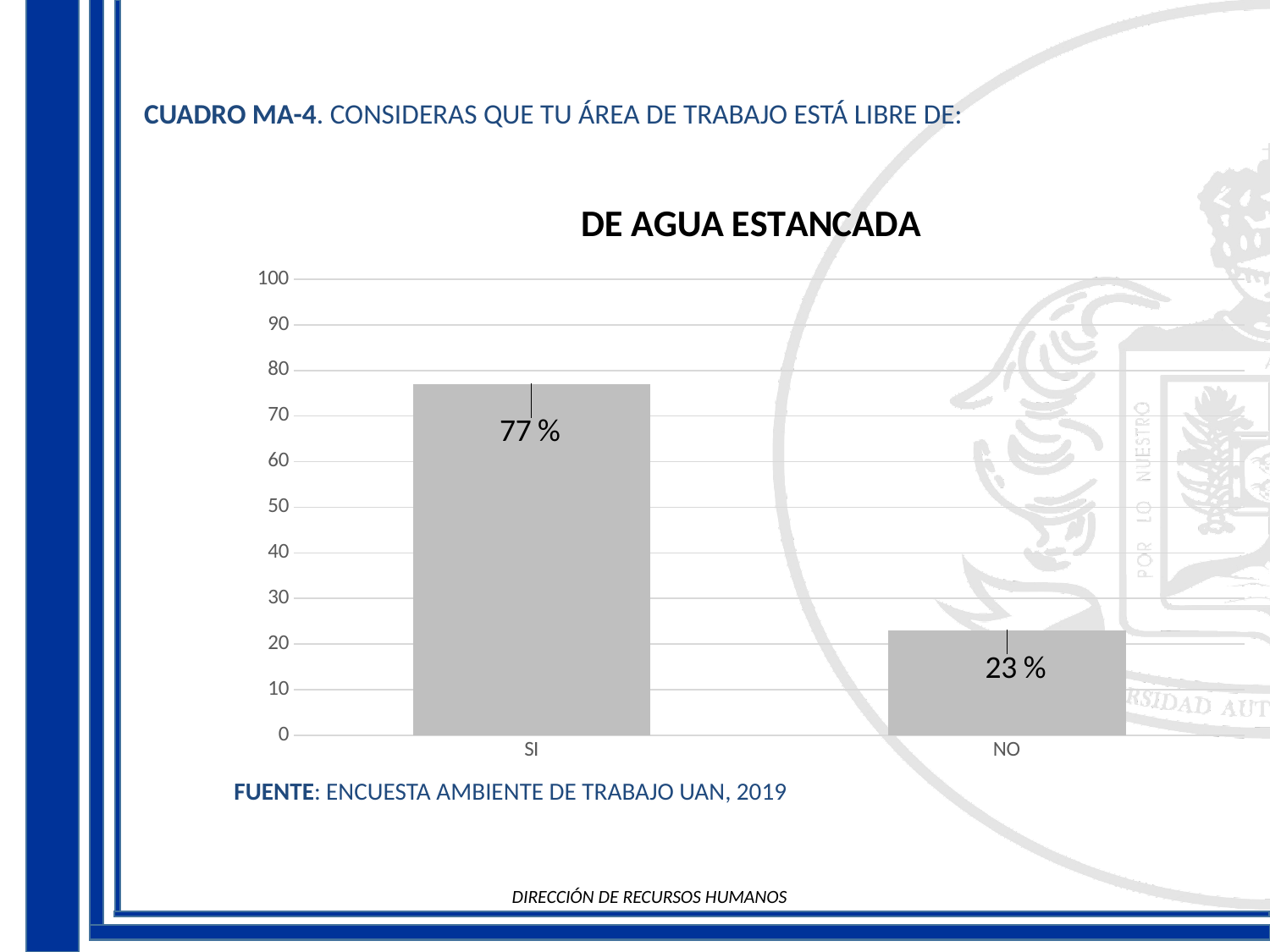
What is the value for SI? 77 % Is the value for SI greater or less than 70? greater What kind of chart is shown on the slide? bar chart What is the maximum value shown on the y axis? 100 Which is larger, the value for SI or the value for NO? SI What is the title of the chart? DE AGUA ESTANCADA Is the value for NO greater or less than 30? less What is the value for NO? 23 % How many categories are shown on the x axis? 2 Which category has the lowest value? NO Which category has the highest value? SI What is the difference between the values for SI and NO? 54 %